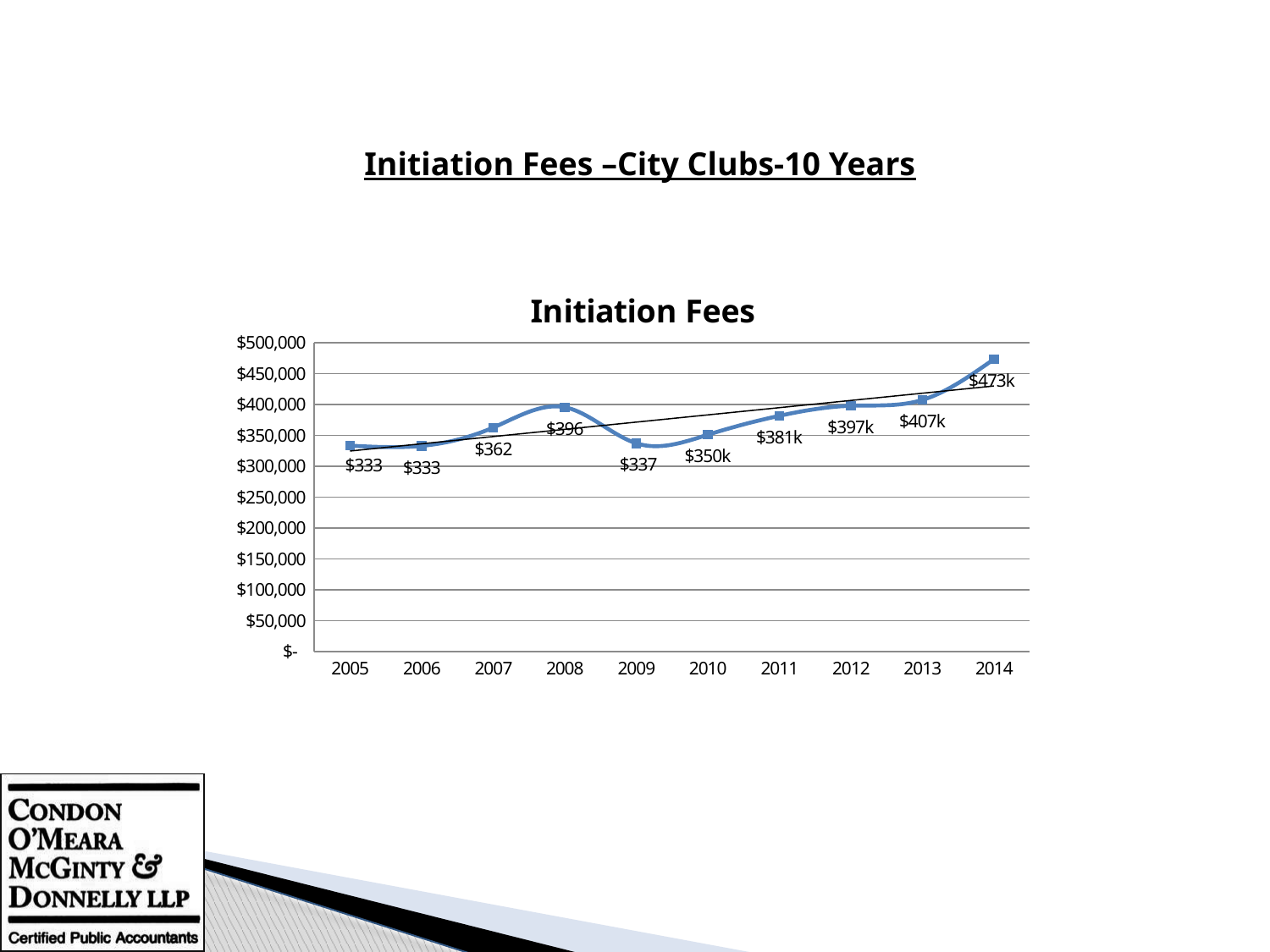
What is the difference between the 2014 and 2013 data labels on the Initiation Fees chart? $66k Which year has the larger initiation fees value, 2008 or 2009? 2008 What is the data label for 2010 on the Initiation Fees chart? $350k Is the value for 2008 on the Initiation Fees chart greater or less than $350,000? greater What is the data label for 2008 on the Initiation Fees chart? $396 What is the data label for 2014 on the Initiation Fees chart? $473k How many years are plotted on the Initiation Fees chart? 10 Do initiation fees generally rise or fall from 2005 to 2014 on the chart? Rise What kind of chart is used to show Initiation Fees? Line chart Which year has the highest initiation fees on the chart? 2014 What is the data label for 2005 on the Initiation Fees chart? $333 What is the difference between the 2012 and 2011 data labels on the Initiation Fees chart? $16k